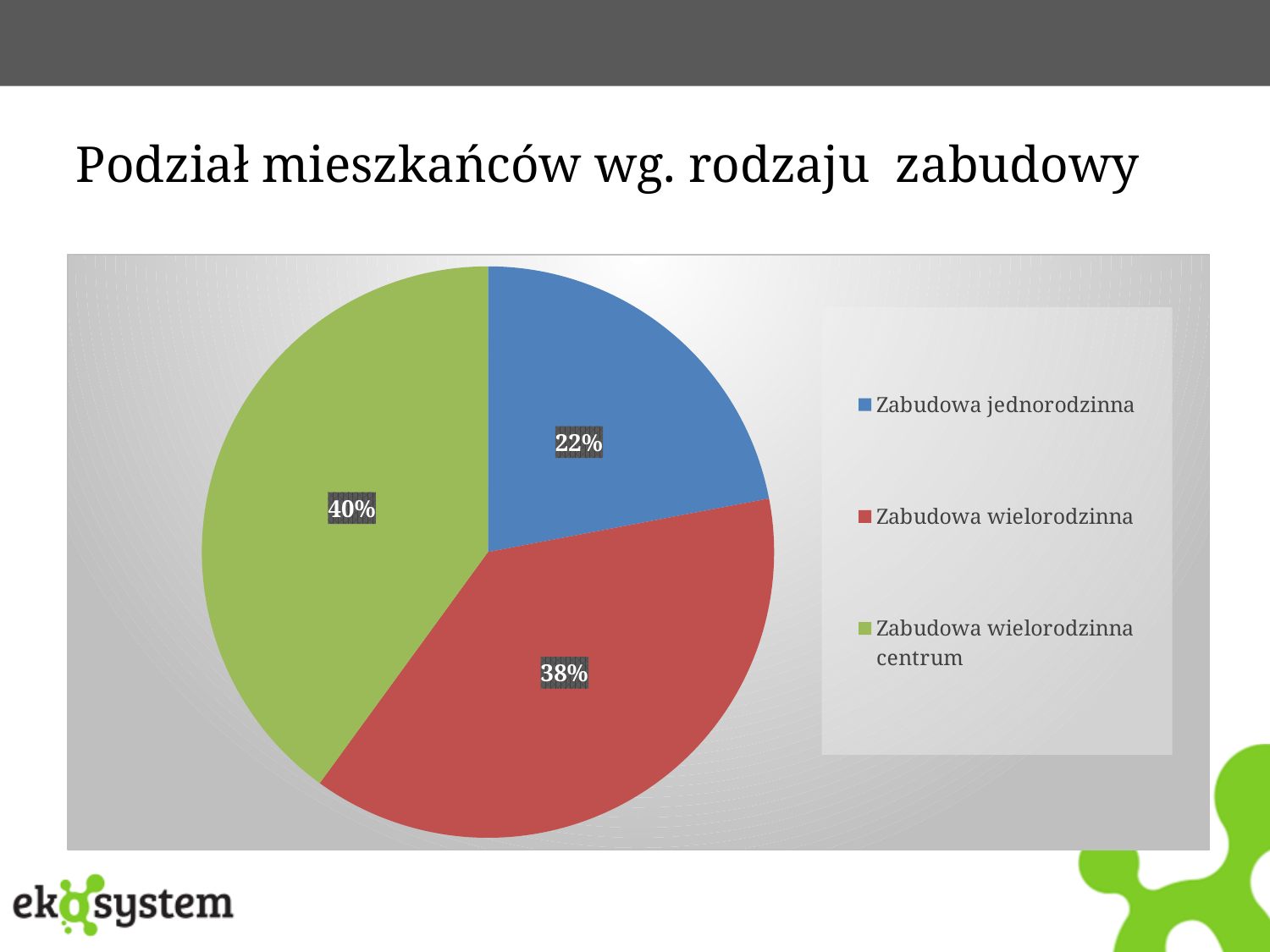
Which category has the smallest share of the pie? Zabudowa jednorodzinna How many slices does the pie chart have? 3 What share of the pie does Zabudowa jednorodzinna have? 22% Which category has the largest share of the pie? Zabudowa wielorodzinna centrum Which is larger: the share for Zabudowa wielorodzinna or the share for Zabudowa jednorodzinna? Zabudowa wielorodzinna What is the difference in percentage points between Zabudowa wielorodzinna centrum and Zabudowa jednorodzinna? 18 What share of the pie does Zabudowa wielorodzinna centrum have? 40% What colour is the slice for Zabudowa wielorodzinna? red What share of the pie does Zabudowa wielorodzinna have? 38% What type of chart is shown on the slide? pie chart What is the title of the slide containing the chart? Podział mieszkańców wg. rodzaju zabudowy How many entries does the legend list? 3